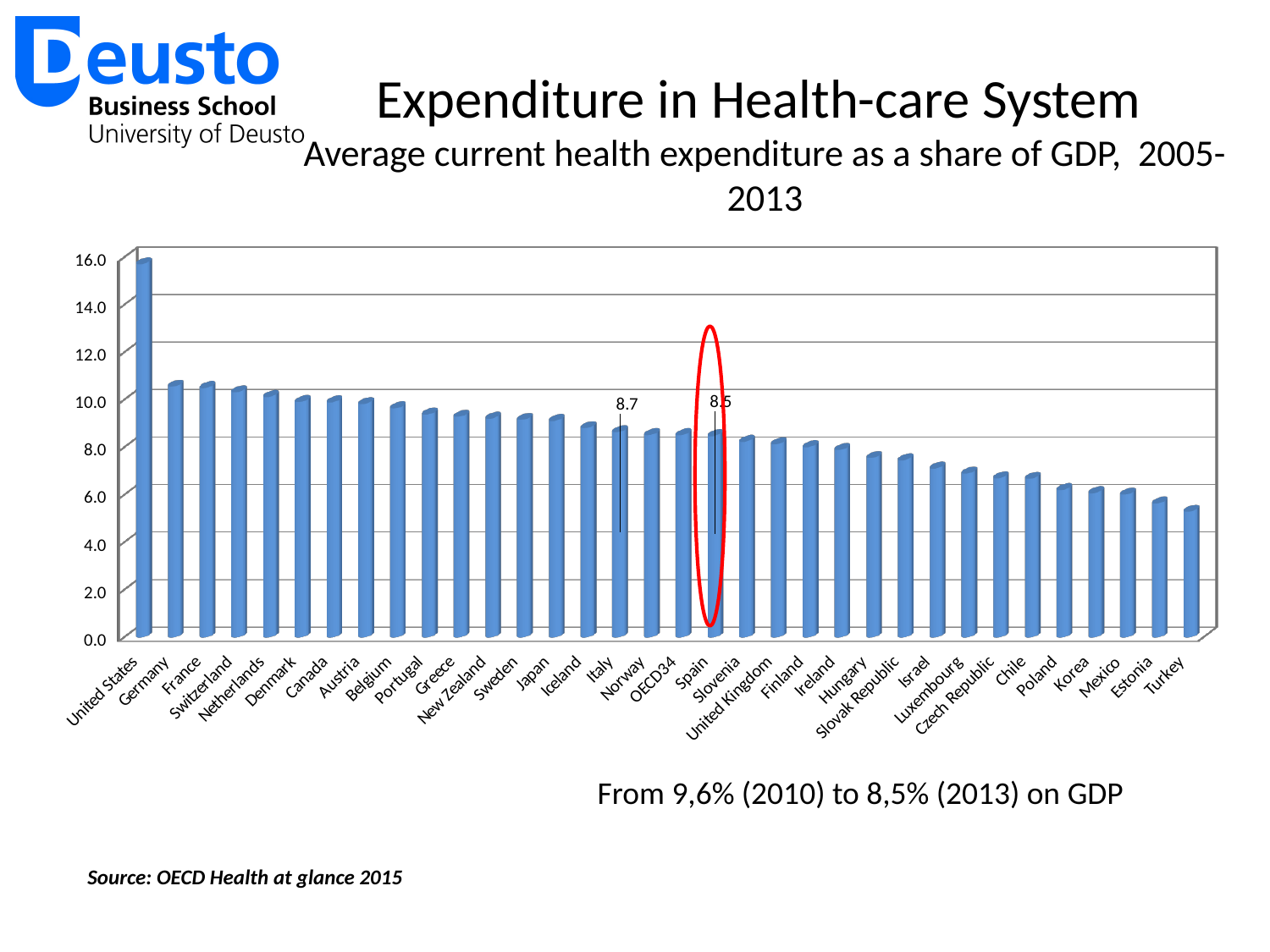
Is the value for Turkey greater or less than 6.0? less Is the value for Germany greater or less than 10.0? greater Do the values generally rise or fall from left to right along the x axis? Fall Which has a larger value, Germany or Turkey? Germany How many categories are shown on the x axis? 34 What kind of chart is shown on the slide? Bar chart Which country has the highest bar? United States Is the value for the United States greater or less than 14.0? greater Which country has the lowest bar? Turkey What is the difference between the values for Italy and Spain? 0.2 What is the value shown for Italy? 8.7 What is the value shown for Spain? 8.5